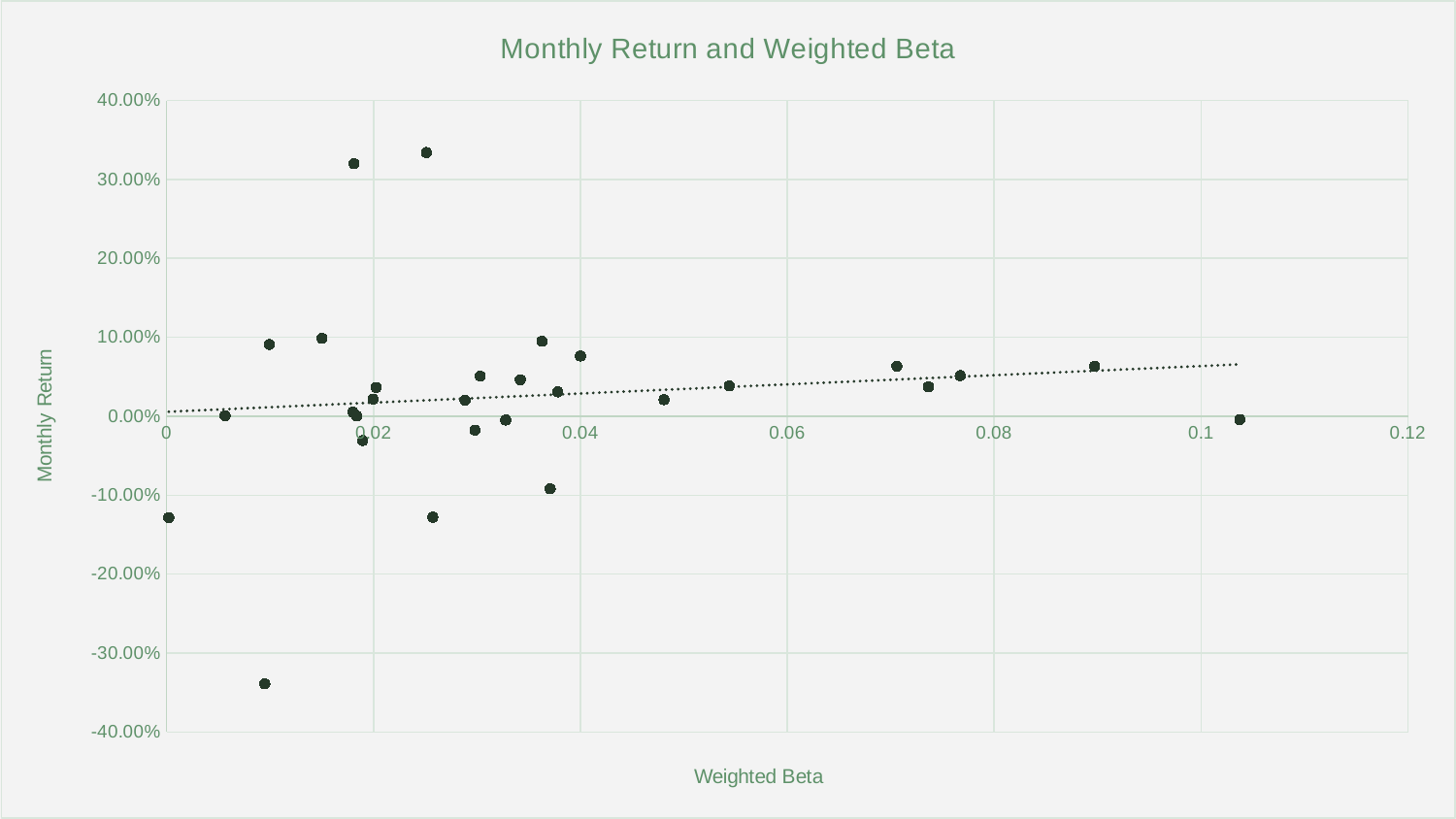
What is the highest value shown on the vertical axis? 40.00% What kind of chart is shown on the slide? Scatter chart Is the Monthly Return of the highest point on the chart greater or less than 30.00%? greater What is the label of the horizontal axis? Weighted Beta Does the dotted trendline rise or fall as Weighted Beta increases? Rises Is the Monthly Return of the lowest point on the chart greater or less than -30.00%? less What is the title of the chart? Monthly Return and Weighted Beta